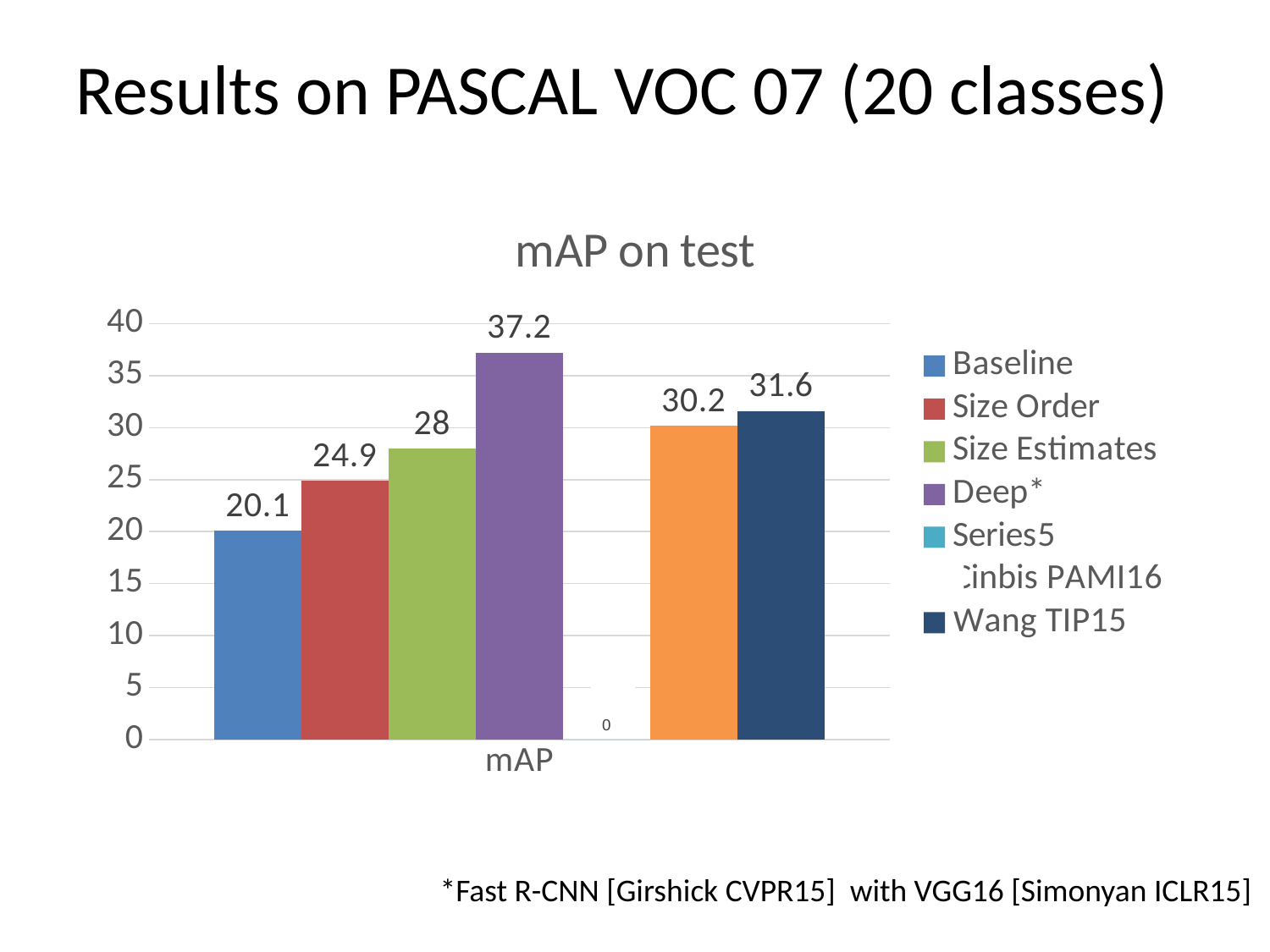
What is the mAP value for Deep*? 37.2 Which is larger, the mAP of Wang TIP15 or Size Estimates? Wang TIP15 What is the difference between the mAP of Deep* and Baseline? 17.1 What is the mAP value for Size Order? 24.9 What is the mAP value for Wang TIP15? 31.6 What is the title of the chart? mAP on test What is the mAP value for Size Estimates? 28 What is the mAP value for Baseline? 20.1 Which series has the lowest non-zero mAP value? Baseline Which series has the highest mAP value? Deep* What type of chart is shown on the slide? bar chart How many series does the legend list? 7